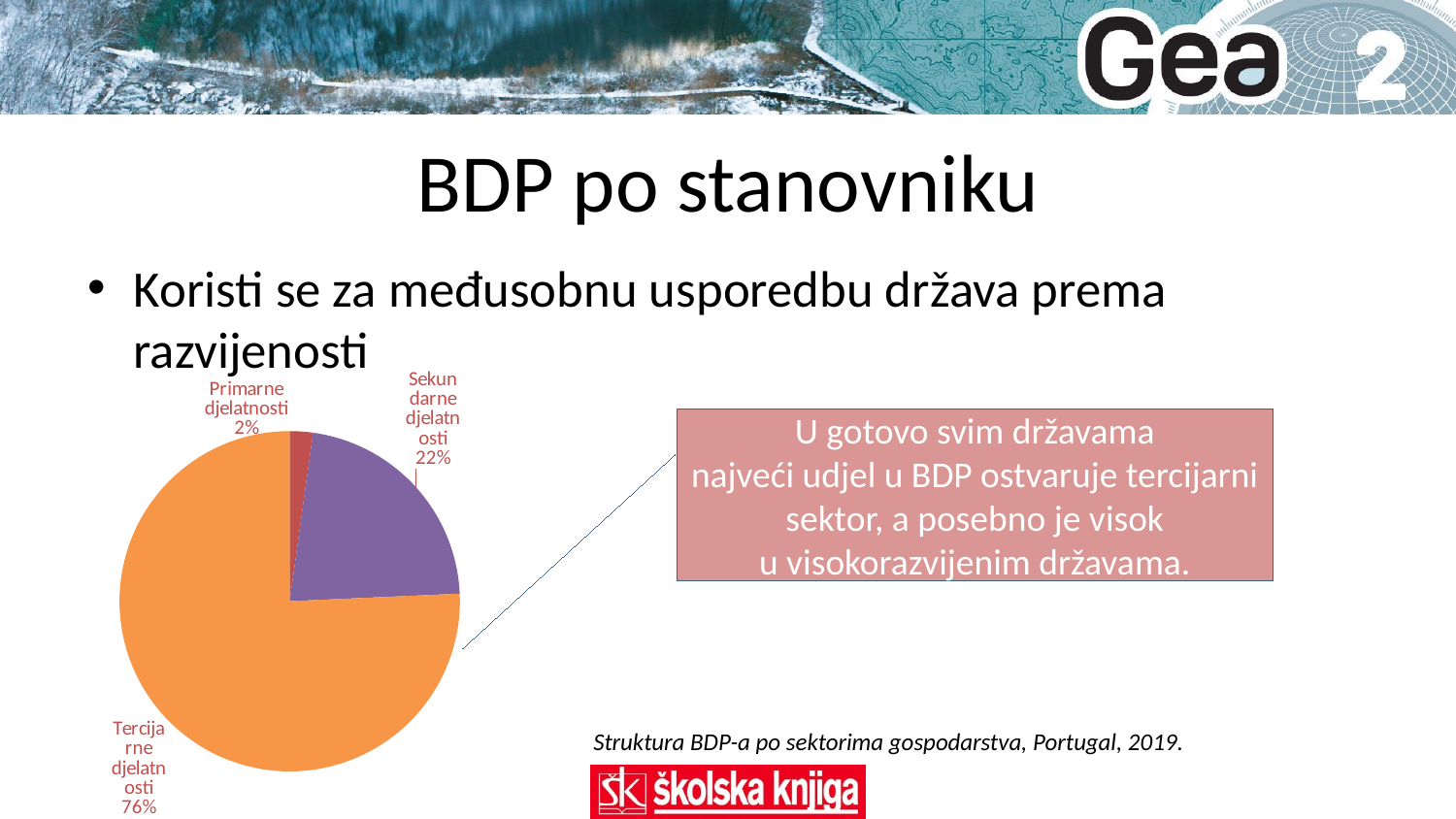
How many slices does the pie chart have? 3 What is the difference in percentage points between Sekundarne djelatnosti and Primarne djelatnosti? 20 Which sector has the smallest share of the pie? Primarne djelatnosti What colour is the slice for Tercijarne djelatnosti? orange Which is larger, the share of Sekundarne djelatnosti or the share of Primarne djelatnosti? Sekundarne djelatnosti What share of the pie does Sekundarne djelatnosti have? 22% What share of the pie does Tercijarne djelatnosti have? 76% What kind of chart is shown on the slide? pie chart What share of the pie does Primarne djelatnosti have? 2% Which country and year does the pie chart describe, according to the caption? Portugal, 2019 Which sector has the largest share of the pie? Tercijarne djelatnosti What is the difference in percentage points between Tercijarne djelatnosti and Sekundarne djelatnosti? 54